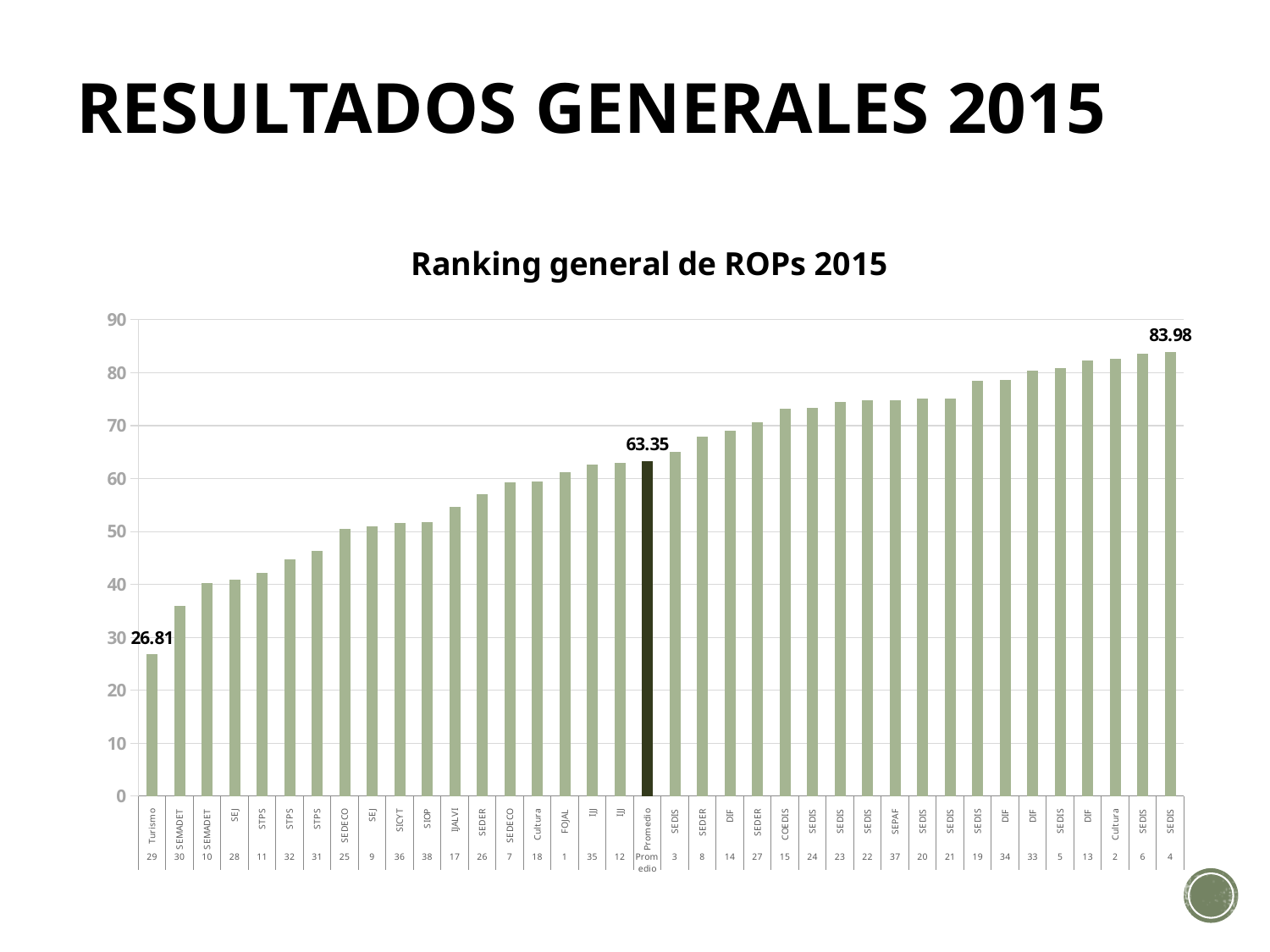
Is the value for SEMADET 30 greater or less than 40? less Which category has the highest value? SEDIS 4 What is the difference between the highest value (SEDIS 4) and the lowest value (Turismo 29)? 57.17 Do the values rise or fall from left to right along the x axis? rise Is the value for SEDIS 19 greater or less than 70? greater What is the value for SEDIS 4? 83.98 What is the value of the Promedio bar? 63.35 What is the value for Turismo 29? 26.81 What is the title of the chart? Ranking general de ROPs 2015 How much higher is SEDIS 4 than the Promedio? 20.63 What type of chart is shown on the slide? bar chart Which category has the lowest value? Turismo 29